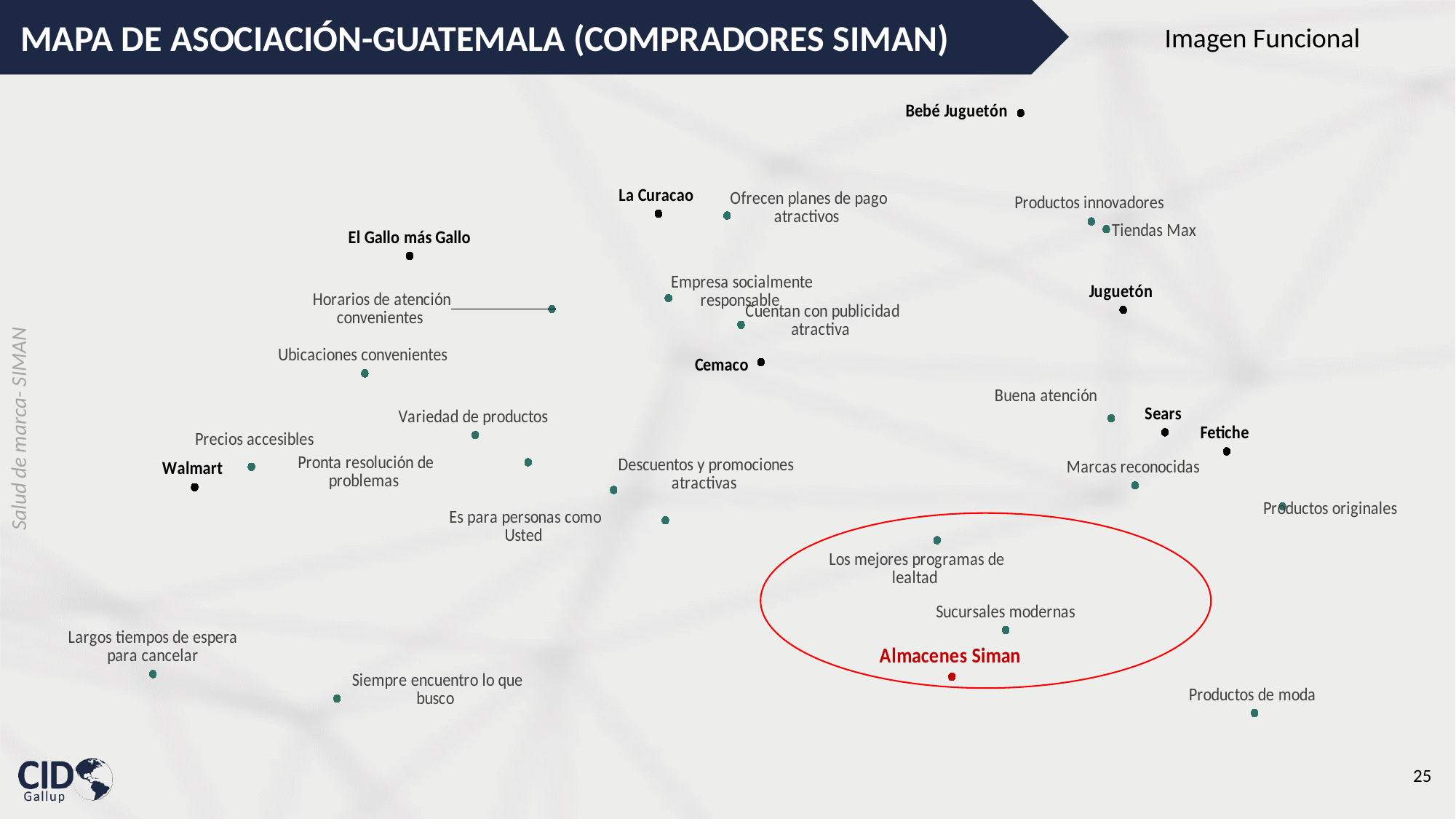
Which brand is shown in red and enclosed by the red ellipse? Almacenes Siman Which two attributes are inside the red ellipse together with Almacenes Siman? Los mejores programas de lealtad; Sucursales modernas Which brand point is closest to the attribute 'Precios accesibles'? Walmart Which brand point is closest to the attribute 'Cuentan con publicidad atractiva'? Cemaco What kind of chart is shown on the slide? scatter chart (association map) What is the title of the chart? MAPA DE ASOCIACIÓN-GUATEMALA (COMPRADORES SIMAN) Which brand point is closest to the attribute 'Buena atención'? Sears What label appears in the top-right corner of the slide describing the type of image mapped? Imagen Funcional Which brand is plotted furthest to the left on the map? Walmart Which brand point is closest to the attribute 'Ofrecen planes de pago atractivos'? La Curacao Which brand is plotted highest on the map? Bebé Juguetón